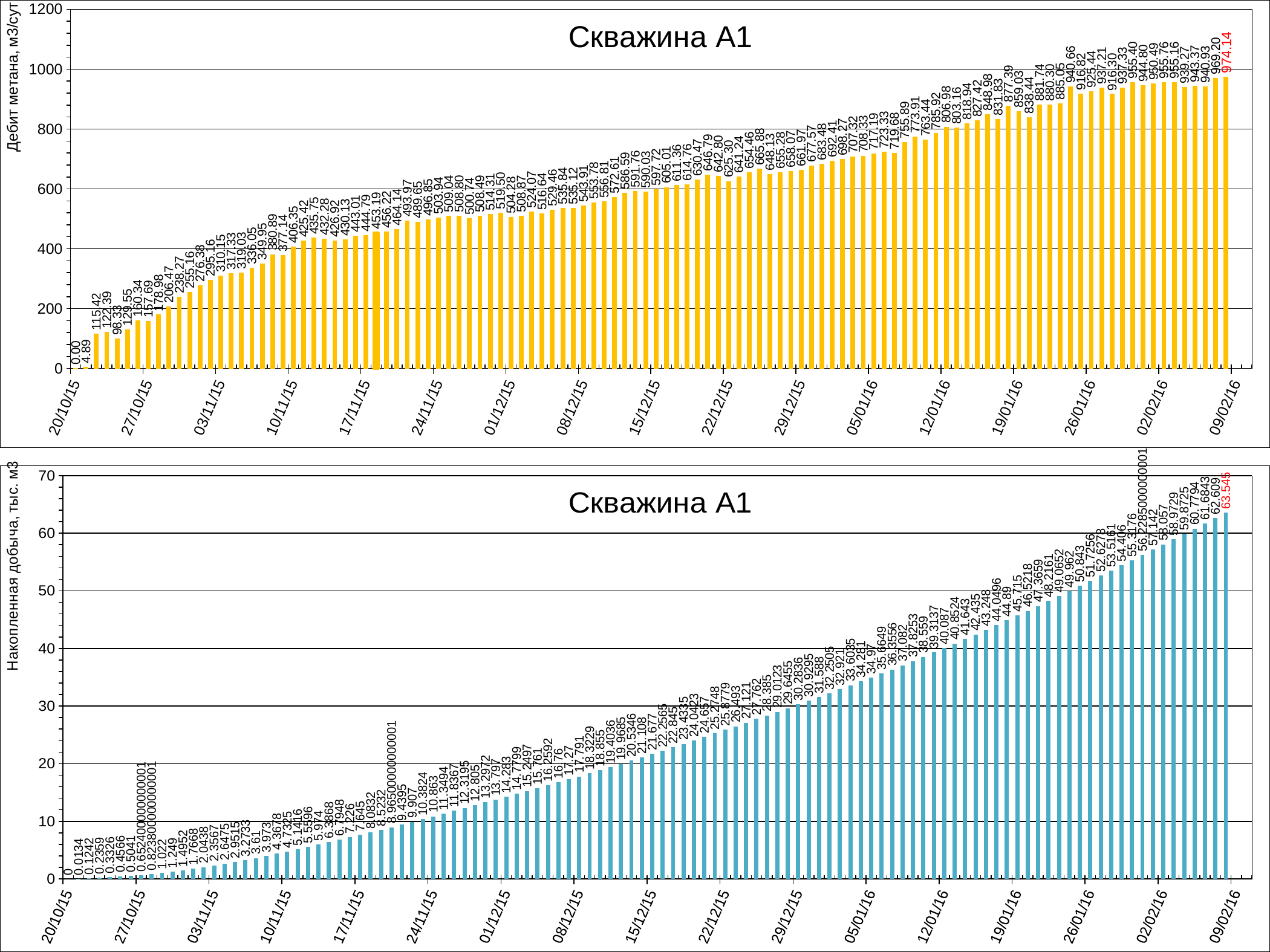
What is the title shown on both charts? Скважина А1 In the bottom chart (Накопленная добыча), which date has the lowest value? 20/10/15 In the top chart (Дебит метана), what is the value of the last bar, on 09/02/16? 974.14 In the bottom chart (Накопленная добыча), what is the value of the last bar, on 09/02/16? 63.545 In the top chart (Дебит метана), is the value of the last bar on 09/02/16 greater or less than 800? greater What kind of chart is the top chart titled "Скважина А1"? bar chart In the bottom chart (Накопленная добыча), what is the value of the first bar, on 20/10/15? 0 What is the y-axis label of the bottom chart? Накопленная добыча, тыс. м3 In the bottom chart (Накопленная добыча), do the values generally rise or fall from 20/10/15 to 09/02/16? rise In the top chart (Дебит метана), what is the value of the first bar, on 20/10/15? 0.00 In the top chart (Дебит метана), what is the difference between the last bar (974.14) and the bar just before it (969.20)? 4.94